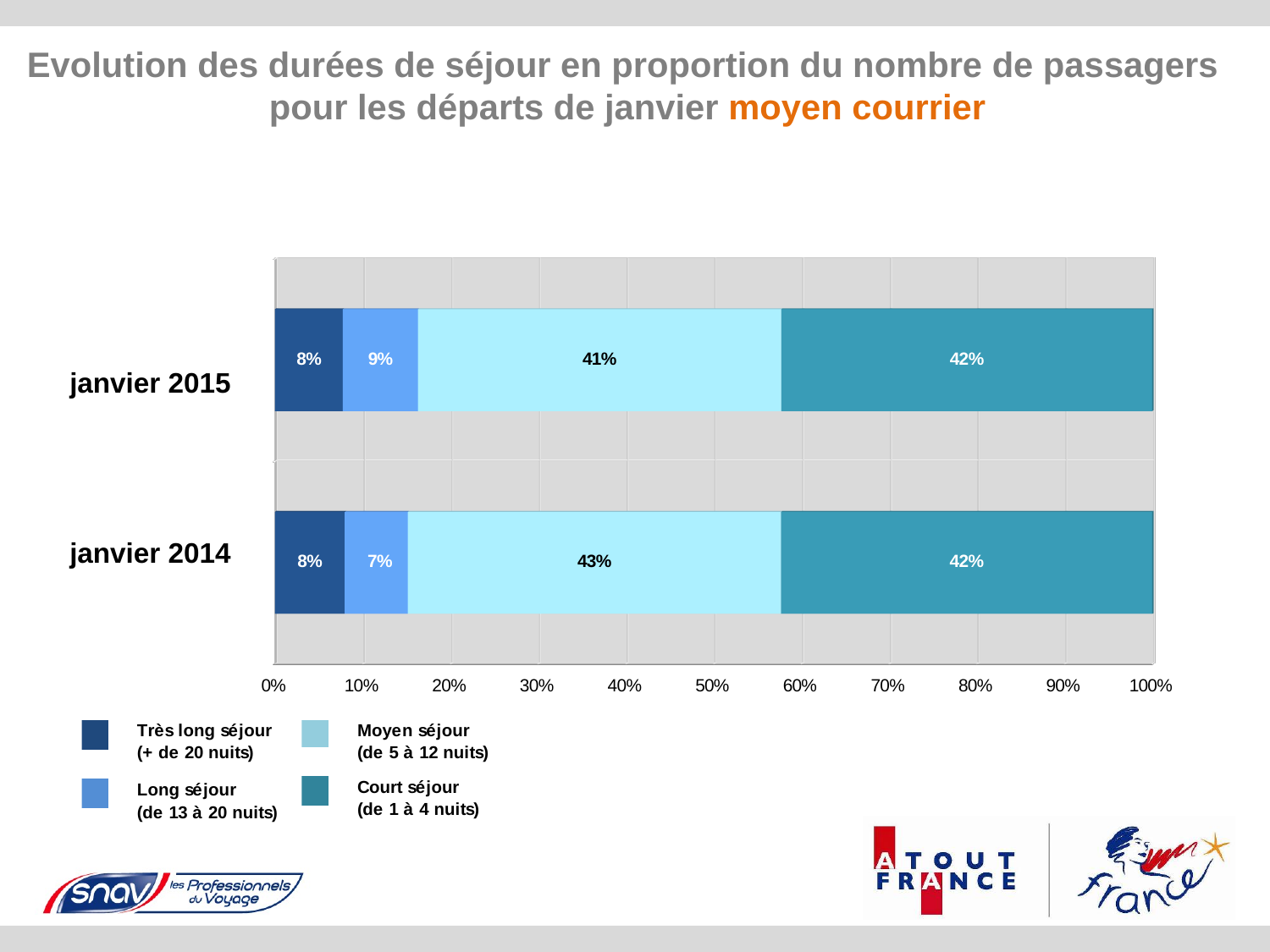
How many categories (years) are shown on the chart? 2 What is the total of the janvier 2015 stacked bar? 100% Which year has the larger Long séjour (de 13 à 20 nuits) share, janvier 2015 or janvier 2014? janvier 2015 What kind of chart is shown on the slide? Stacked bar chart How many series does the legend list? 4 What is the difference between the Moyen séjour values for janvier 2014 and janvier 2015? 2% What is the value for Court séjour (de 1 à 4 nuits) in janvier 2015? 42% Which segment is the largest in the janvier 2014 bar? Moyen séjour (de 5 à 12 nuits) What is the value for Très long séjour (+ de 20 nuits) in janvier 2014? 8% What is the value for Long séjour (de 13 à 20 nuits) in janvier 2014? 7% What is the value for Moyen séjour (de 5 à 12 nuits) in janvier 2015? 41% Which segment is the smallest in the janvier 2015 bar? Très long séjour (+ de 20 nuits)